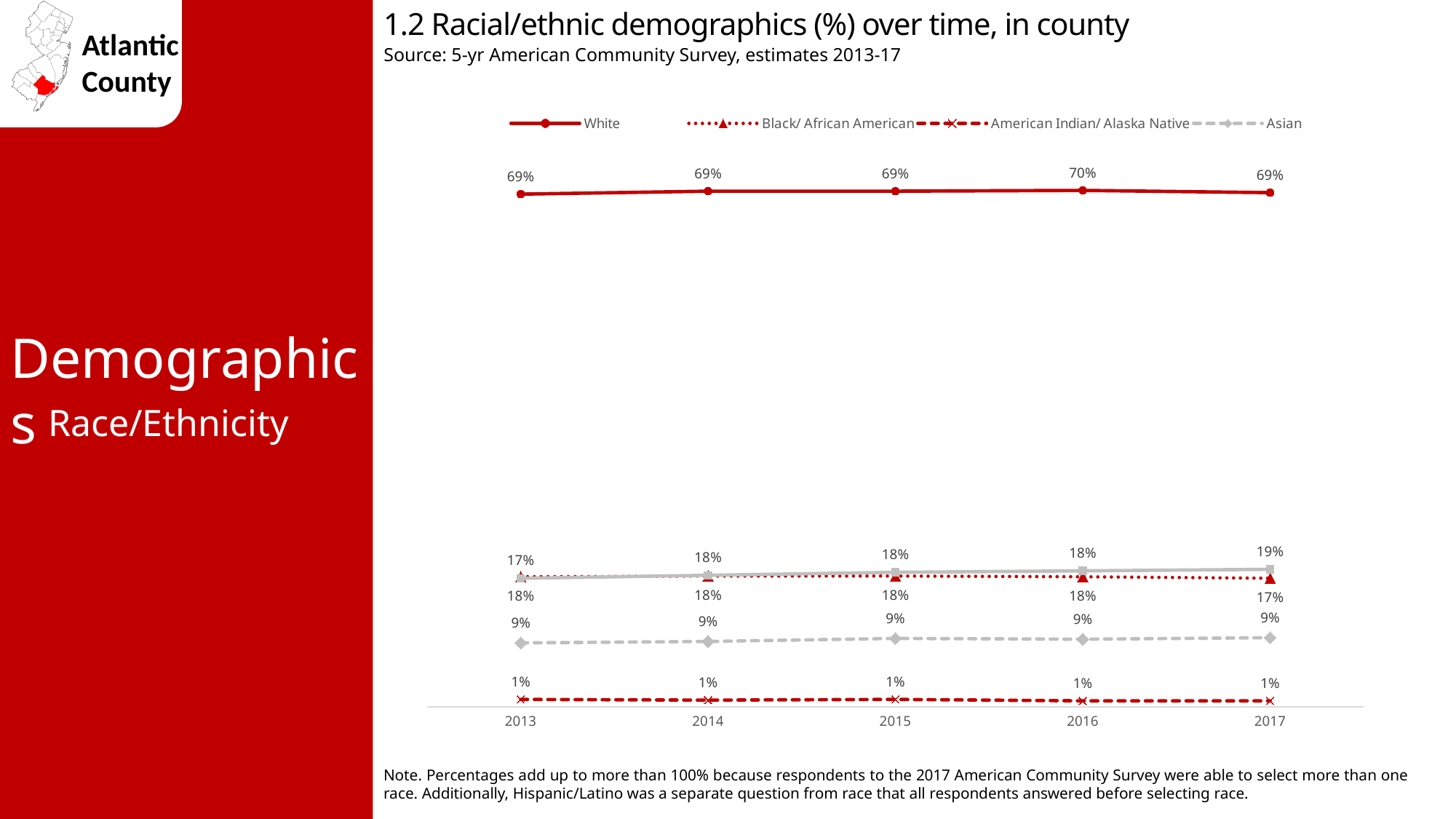
What is the value for Asian in 2015? 9% Which series has the lowest values across all years? American Indian/ Alaska Native What is the value for White in 2013? 69% What is the value for Black/ African American in 2015? 18% What is the difference between the White and Asian values in 2016? 61 percentage points What is the value for American Indian/ Alaska Native in 2017? 1% Which is larger in 2014, the Asian value or the American Indian/ Alaska Native value? Asian What kind of chart is shown on the slide? Line chart In which year is the White percentage highest? 2016 How many years are shown on the x axis? 5 What is the source cited under the chart title? 5-yr American Community Survey, estimates 2013-17 How many series does the legend list? 4